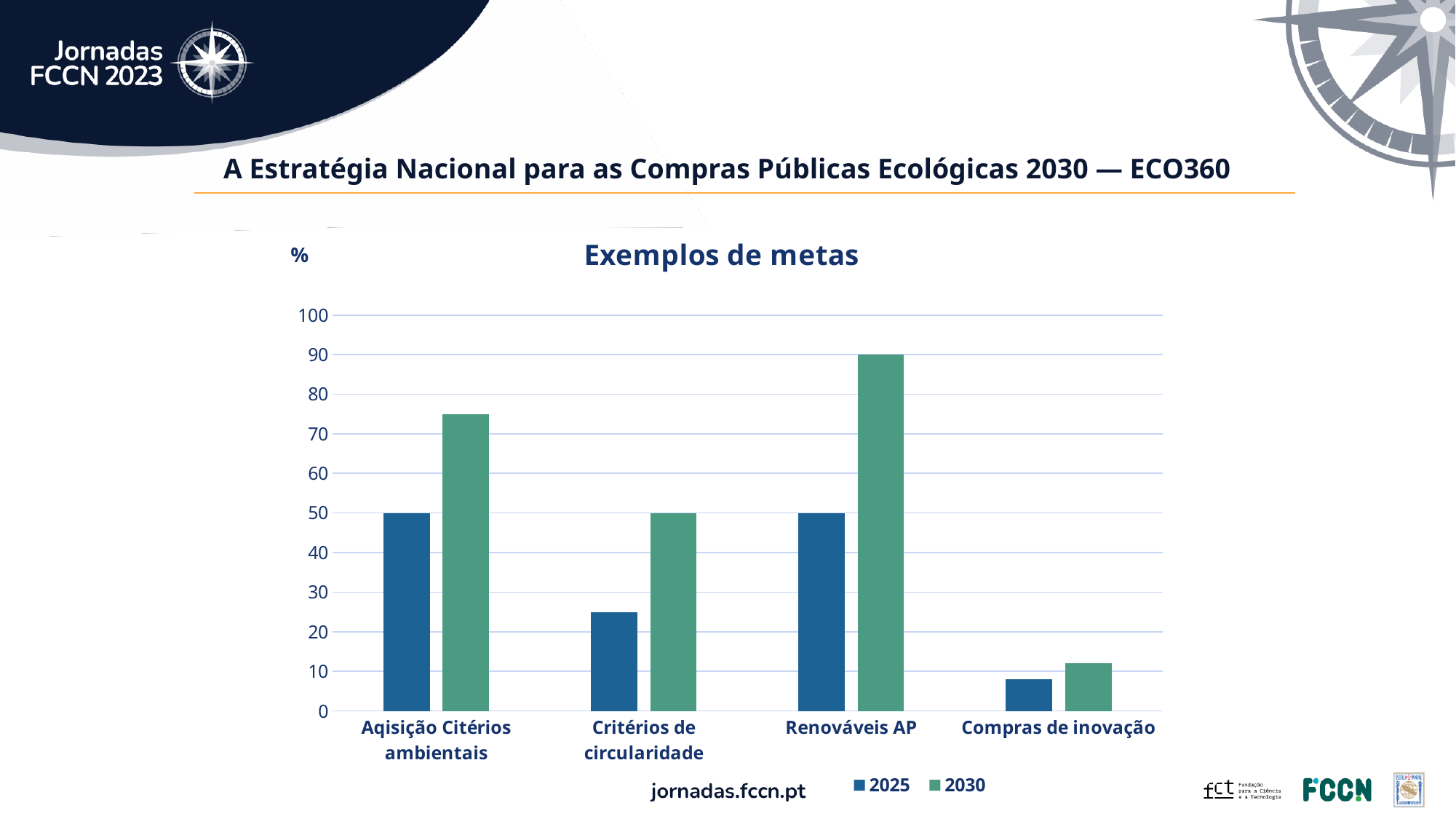
What is the 2025 value for Aqisição Citérios ambientais? 50 Which category has the lowest 2025 value? Compras de inovação Is the 2025 value for Critérios de circularidade greater or less than 30? less How many categories are shown on the x axis? 4 Which category has the highest 2030 value? Renováveis AP Is the 2030 value for Aqisição Citérios ambientais greater or less than 70? greater What is the 2030 value for Renováveis AP? 90 How many series does the legend list? 2 What is the difference between the 2030 and 2025 values for Renováveis AP? 40 What is the 2025 value for Renováveis AP? 50 What is the 2030 value for Critérios de circularidade? 50 What type of chart is shown on the slide? bar chart